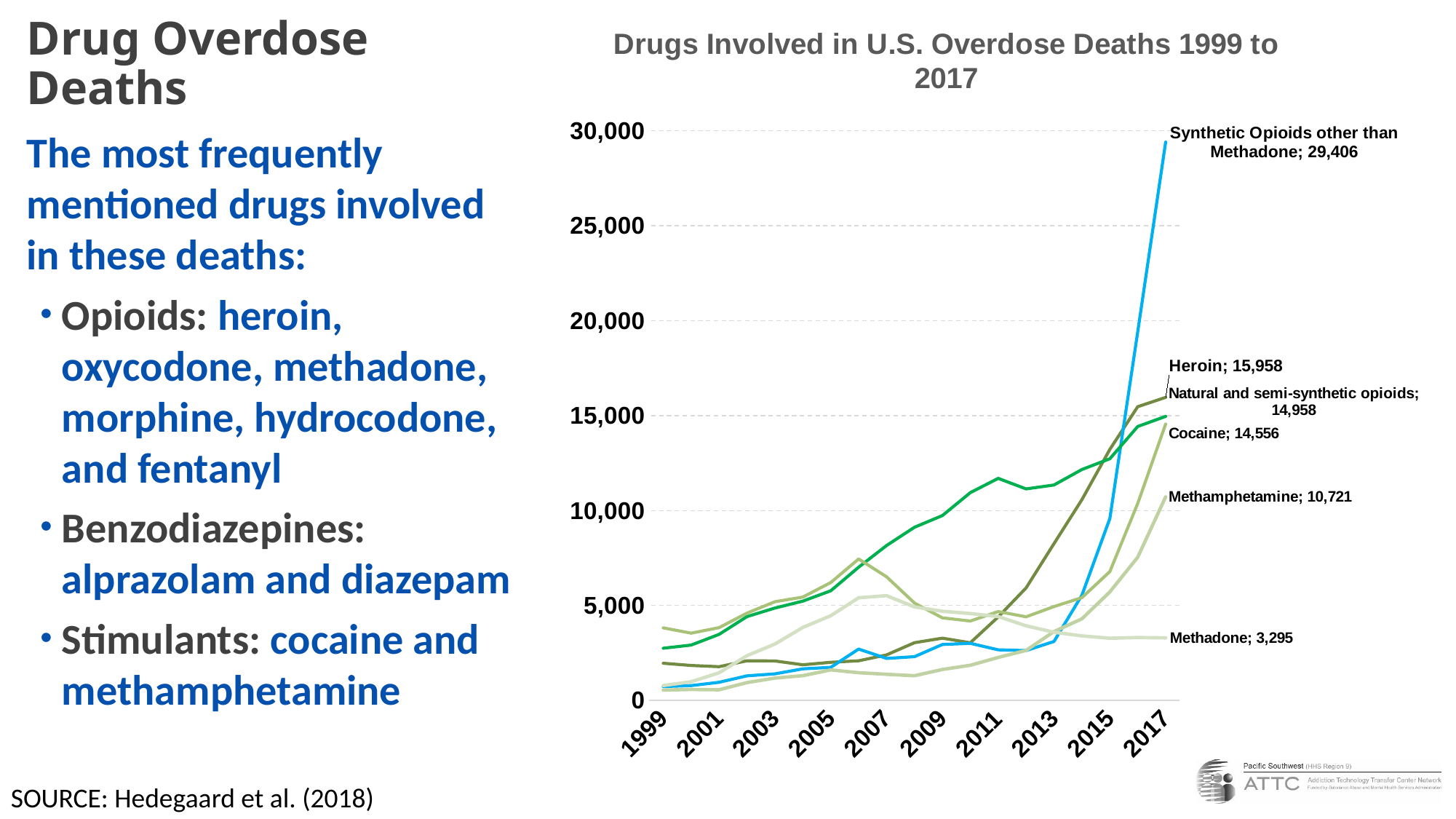
Is the value for Synthetic Opioids other than Methadone in 2013 greater or less than 5,000? less Which drug has the lowest labelled value in 2017? Methadone What kind of chart is shown on the slide? line chart Which drug has the highest labelled value in 2017? Synthetic Opioids other than Methadone What is the 2017 value labelled for Synthetic Opioids other than Methadone? 29,406 Does the line for Synthetic Opioids other than Methadone rise or fall between 2013 and 2017? rise Which has the larger 2017 value, Cocaine or Methamphetamine? Cocaine How many drug series are plotted on the chart? 6 What is the 2017 value labelled for Heroin? 15,958 What is the difference between the 2017 values for Natural and semi-synthetic opioids and Cocaine? 402 What is the difference between the 2017 values for Synthetic Opioids other than Methadone and Heroin? 13,448 What is the 2017 value labelled for Methadone? 3,295